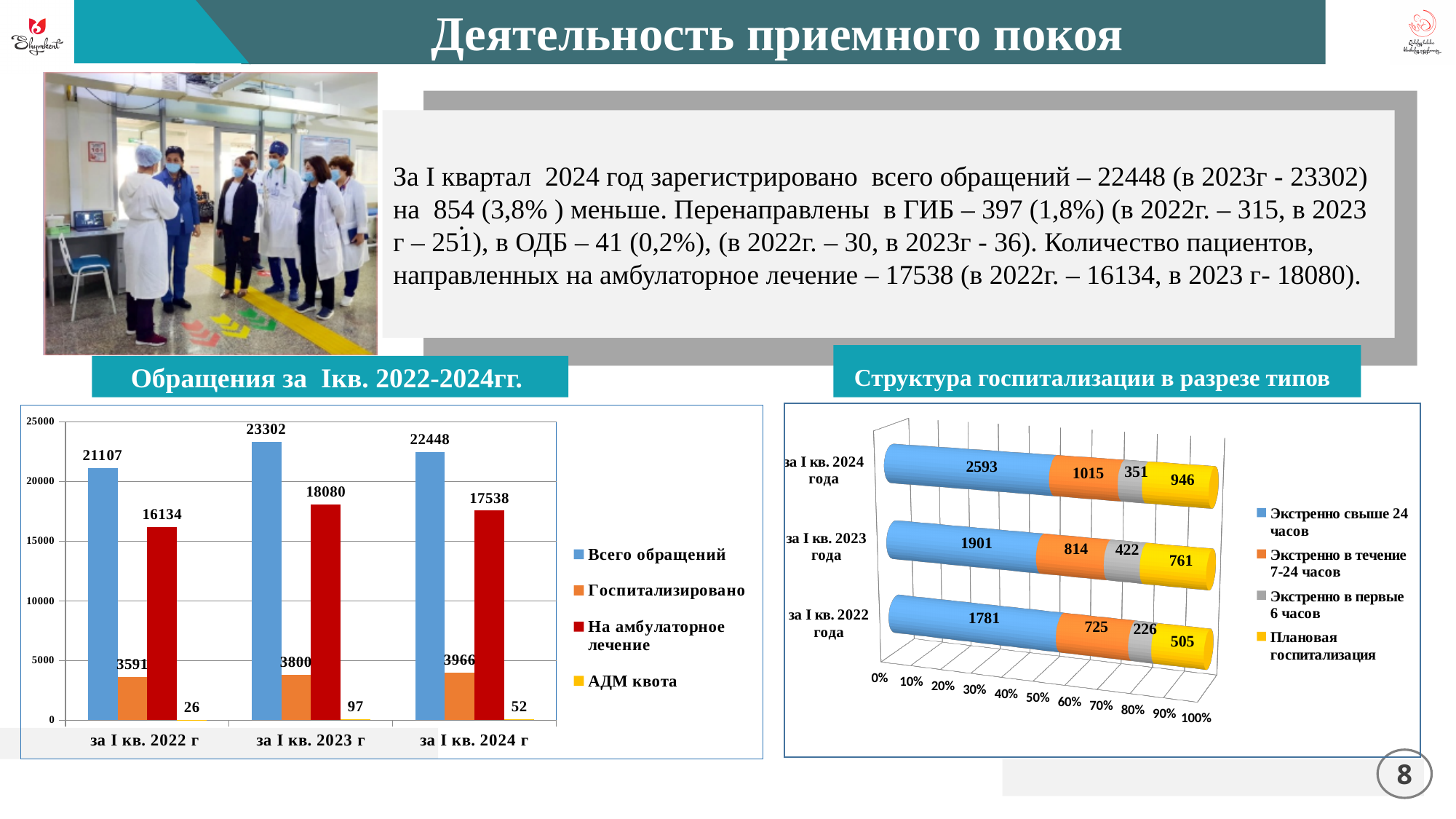
In the chart 'Структура госпитализации в разрезе типов', what is the total of the stacked bar for 'за I кв. 2024 года'? 4905 In the chart 'Обращения за Iкв. 2022-2024гг.', which category has the highest value for 'АДМ квота'? за I кв. 2023 г In the chart 'Обращения за Iкв. 2022-2024гг.', what is the value of 'Всего обращений' for 'за I кв. 2023 г'? 23302 In the chart 'Структура госпитализации в разрезе типов', how many categories are shown? 3 In the chart 'Обращения за Iкв. 2022-2024гг.', does the value of 'На амбулаторное лечение' rise or fall from 'за I кв. 2023 г' to 'за I кв. 2024 г'? fall In the chart 'Обращения за Iкв. 2022-2024гг.', how many series does the legend list? 4 In the chart 'Обращения за Iкв. 2022-2024гг.', what is the value of 'Госпитализировано' for 'за I кв. 2024 г'? 3966 In the chart 'Структура госпитализации в разрезе типов', what is the value of 'Экстренно в первые 6 часов' for 'за I кв. 2023 года'? 422 In the chart 'Обращения за Iкв. 2022-2024гг.', what is the difference between 'Всего обращений' for 'за I кв. 2023 г' and 'за I кв. 2024 г'? 854 In the chart 'Структура госпитализации в разрезе типов', what colour represents 'Экстренно свыше 24 часов'? blue In the chart 'Обращения за Iкв. 2022-2024гг.', what kind of chart is it? bar chart In the chart 'Структура госпитализации в разрезе типов', which is larger: 'Плановая госпитализация' for 'за I кв. 2022 года' or for 'за I кв. 2023 года'? за I кв. 2023 года